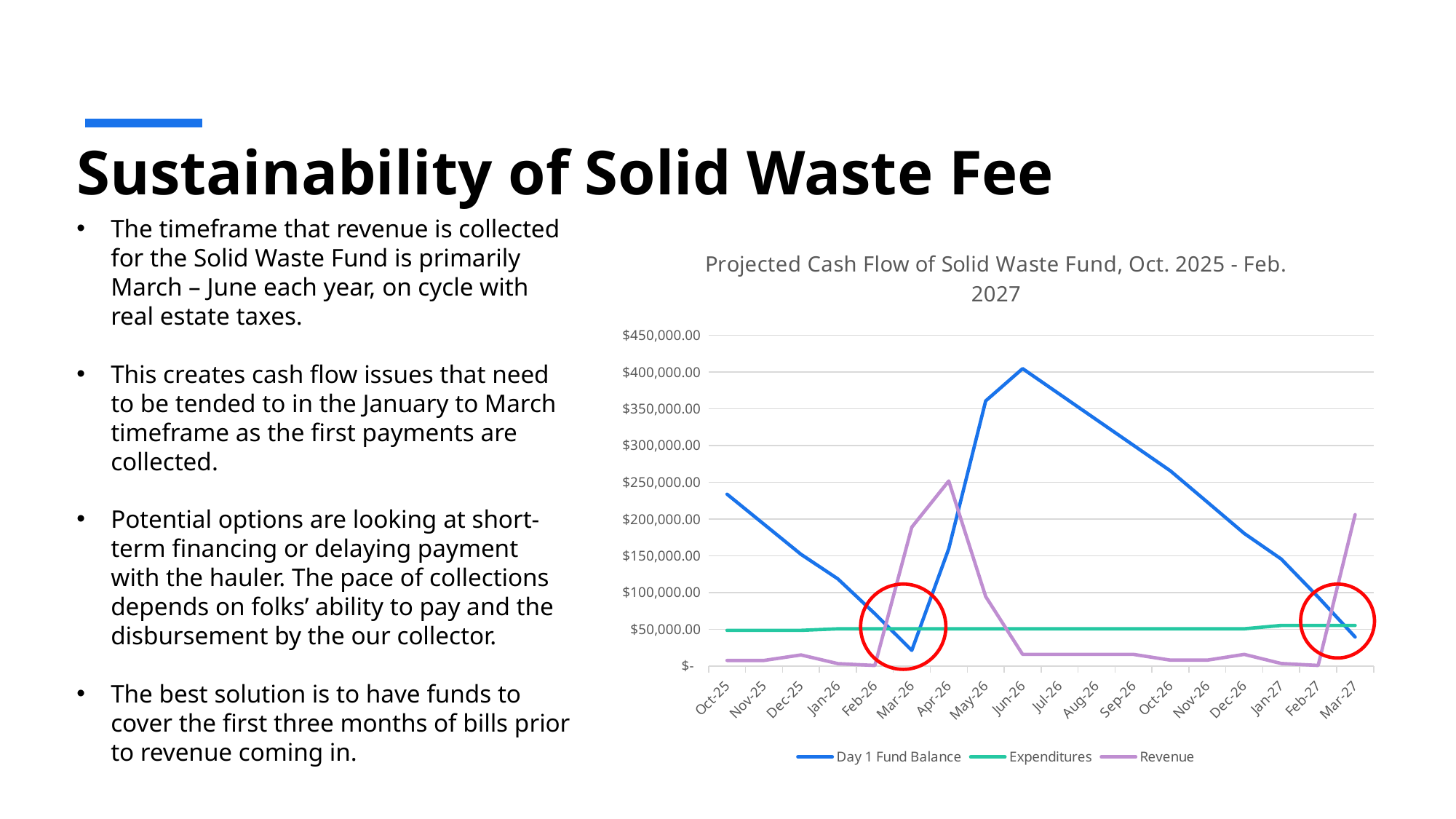
In which month does the Day 1 Fund Balance reach its highest value? Jun-26 How many months are plotted along the x axis of the chart? 18 Is the Revenue for Apr-26 greater or less than $200,000.00? greater How many series does the chart legend list? 3 What kind of chart is shown on the slide? line chart What is the title of the chart? Projected Cash Flow of Solid Waste Fund, Oct. 2025 - Feb. 2027 Is the Day 1 Fund Balance for Jun-26 greater or less than $350,000.00? greater Is the Day 1 Fund Balance for Mar-26 greater or less than $50,000.00? less In which month does Revenue reach its highest value? Apr-26 In which month does the Day 1 Fund Balance reach its lowest value? Mar-26 Does the Day 1 Fund Balance rise or fall from Jun-26 to Mar-27? fall Which is larger, the Day 1 Fund Balance in Oct-25 or in Jun-26? Jun-26